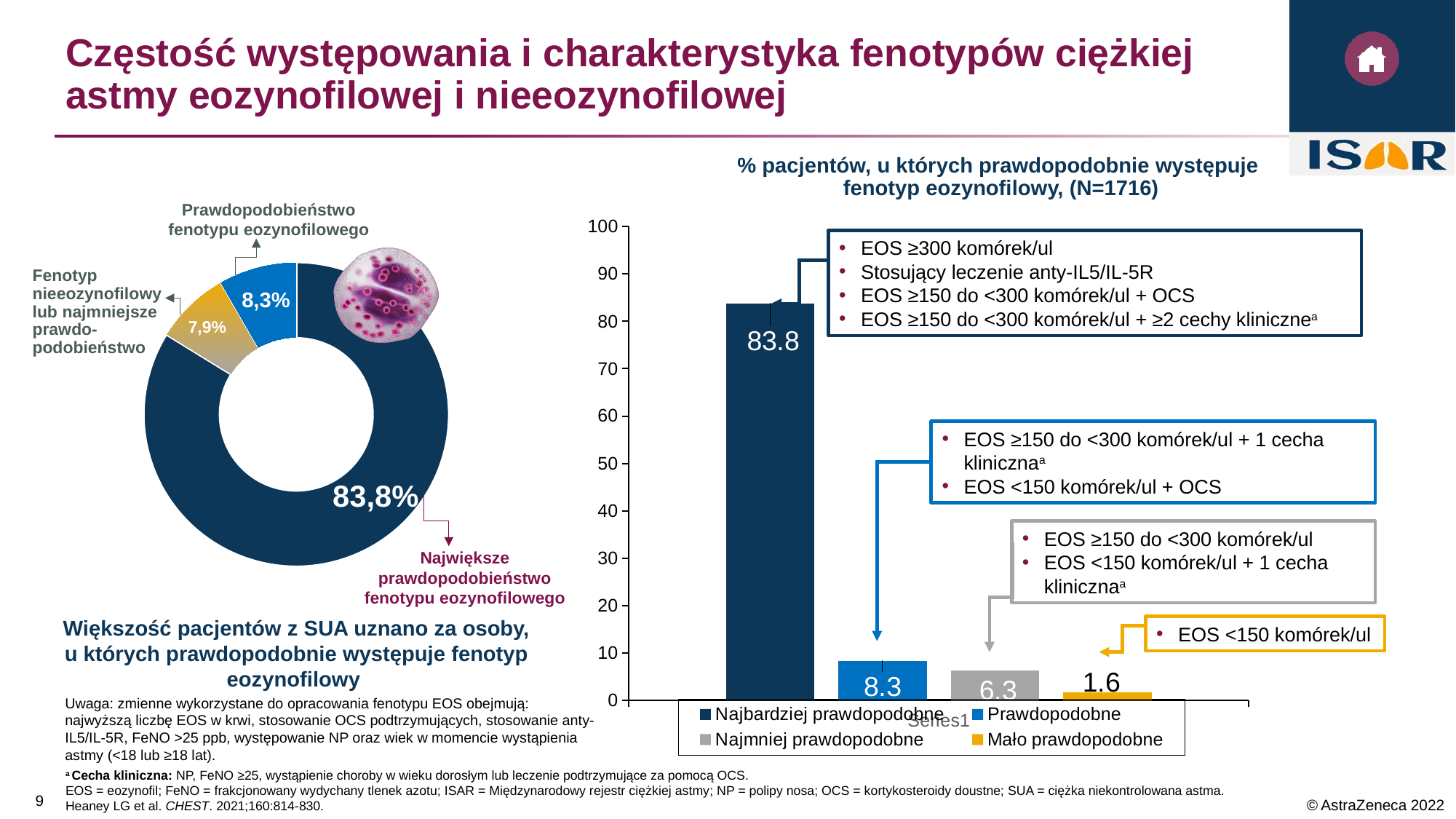
What kind of chart is shown on the left side of the slide? Donut (pie) chart In the donut chart on the left, what share is labelled "Fenotyp nieeozynofilowy lub najmniejsze prawdopodobieństwo"? 7,9% In the bar chart on the right, what is the value for "Mało prawdopodobne"? 1.6 In the bar chart on the right, what is the difference between the values for "Najbardziej prawdopodobne" and "Prawdopodobne"? 75.5 In the bar chart on the right, how many series does the legend list? 4 In the bar chart titled "% pacjentów, u których prawdopodobnie występuje fenotyp eozynofilowy", what is the value for "Najbardziej prawdopodobne"? 83.8 In the bar chart on the right, is the value for "Najbardziej prawdopodobne" greater or less than 80? greater In the bar chart on the right, what is the value for "Prawdopodobne"? 8.3 In the bar chart on the right, which series has the lowest value? Mało prawdopodobne In the bar chart on the right, what is the value for "Najmniej prawdopodobne"? 6.3 In the donut chart on the left, which is larger: the 8,3% slice or the 7,9% slice? 8,3% In the donut chart on the left, what share is labelled "Największe prawdopodobieństwo fenotypu eozynofilowego"? 83,8%